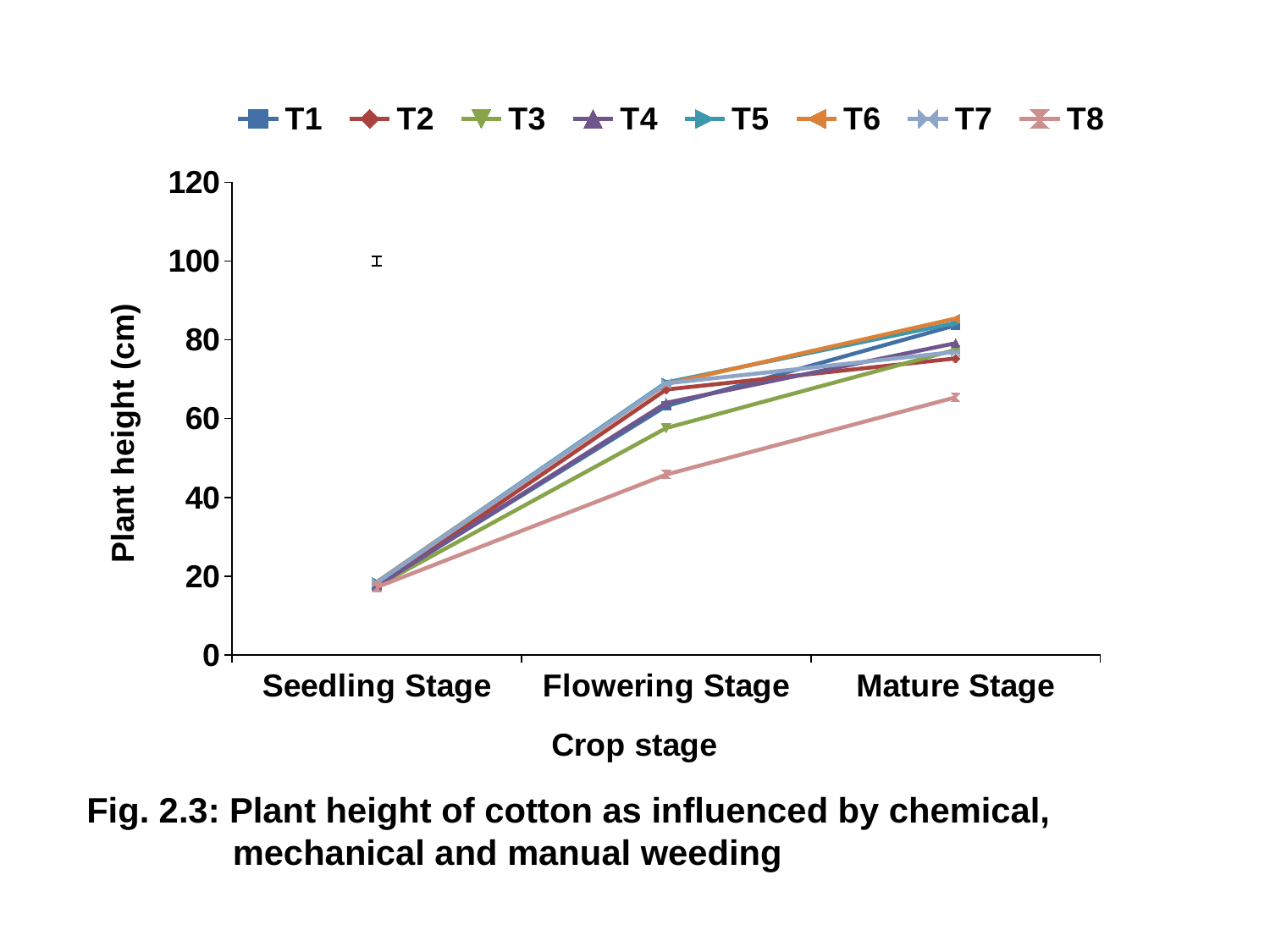
Is the value for T8 at the Mature Stage greater or less than 60? greater What kind of chart is shown on the slide? line chart Which series has the lowest plant height at the Mature Stage? T8 Do the plant height values rise or fall from the Seedling Stage to the Mature Stage? rise How many series does the legend list? 8 At the Mature Stage, which is larger, the value for T6 or the value for T8? T6 What is the title of the y axis? Plant height (cm) Is the value for T6 at the Mature Stage greater or less than 80? greater Is the value for T8 at the Flowering Stage greater or less than 60? less Which series has the lowest plant height at the Flowering Stage? T8 How many crop stages are plotted along the x axis? 3